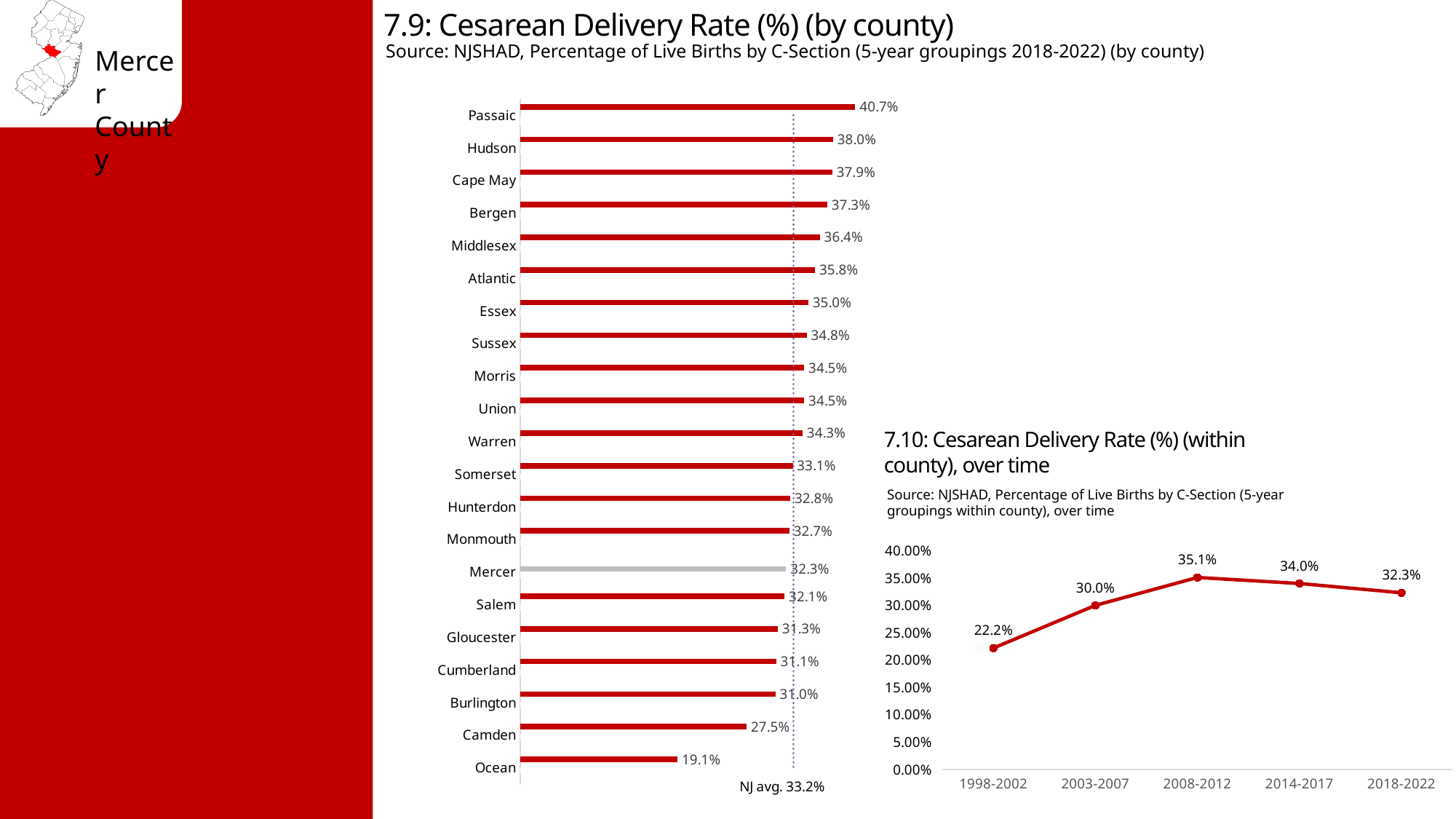
In the chart '7.9: Cesarean Delivery Rate (%) (by county)', what is the difference between the values for Passaic and Ocean? 21.6% In the chart '7.9: Cesarean Delivery Rate (%) (by county)', how many counties are shown? 21 What kind of chart is '7.9: Cesarean Delivery Rate (%) (by county)'? Bar chart In the chart '7.10: Cesarean Delivery Rate (%) (within county), over time', what is the difference between the values for 2008-2012 and 2018-2022? 2.8% In the chart '7.10: Cesarean Delivery Rate (%) (within county), over time', what is the value for 2008-2012? 35.1% In the chart '7.9: Cesarean Delivery Rate (%) (by county)', what is the NJ average shown? 33.2% In the chart '7.9: Cesarean Delivery Rate (%) (by county)', which has a higher value, Hudson or Camden? Hudson In the chart '7.9: Cesarean Delivery Rate (%) (by county)', what is the value for Mercer? 32.3% In the chart '7.10: Cesarean Delivery Rate (%) (within county), over time', which period has the lowest value? 1998-2002 What kind of chart is '7.10: Cesarean Delivery Rate (%) (within county), over time'? Line chart In the chart '7.9: Cesarean Delivery Rate (%) (by county)', which county has the lowest cesarean delivery rate? Ocean In the chart '7.9: Cesarean Delivery Rate (%) (by county)', which county has the highest cesarean delivery rate? Passaic